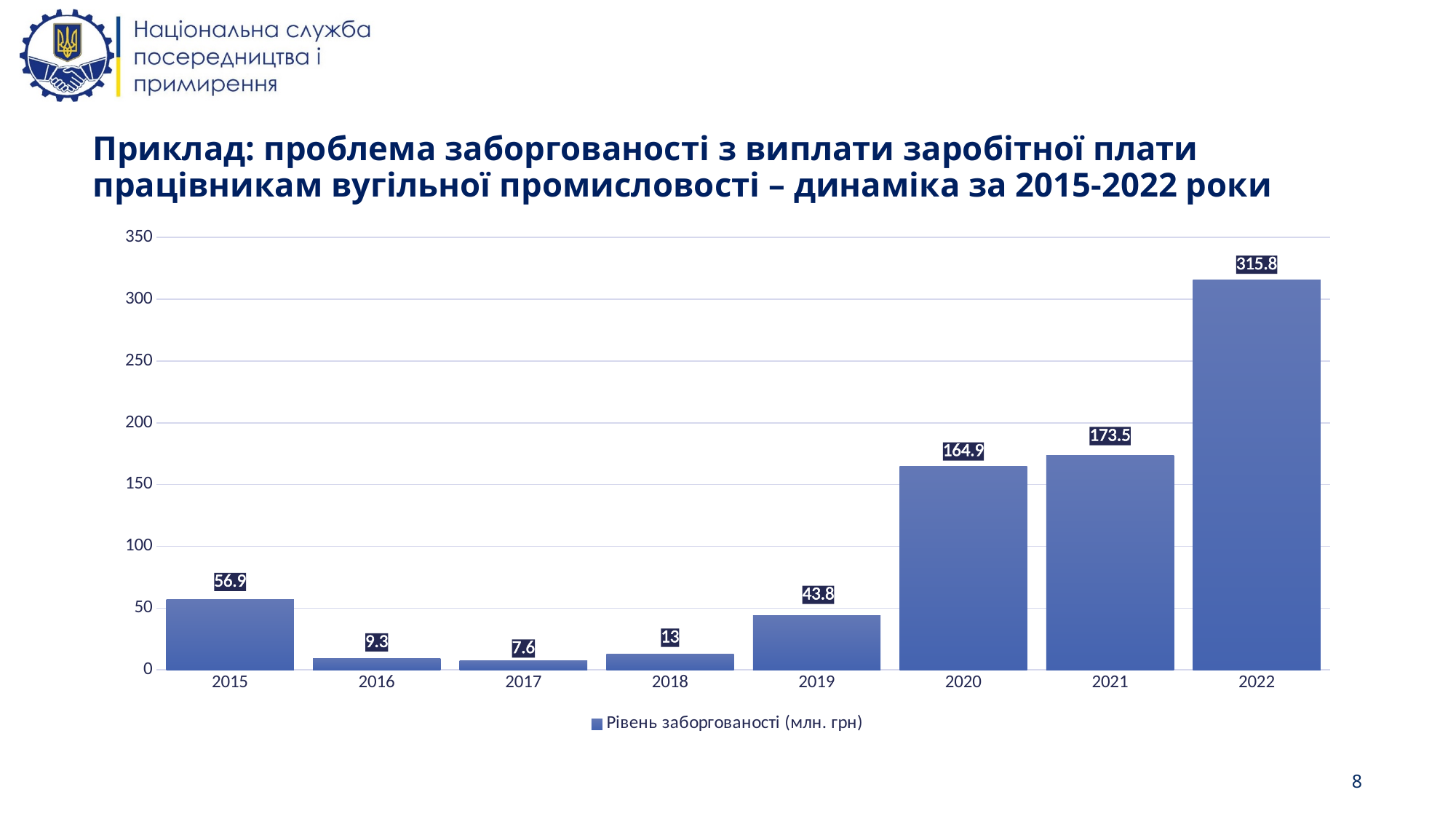
What is the value for 2020? 164.9 Is the value for 2021 greater or less than 150? greater What is the difference between the values for 2022 and 2021? 142.3 What kind of chart is shown on the slide? bar chart What is the value for 2018? 13 What is the legend entry for the series? Рівень заборгованості (млн. грн) How many years are shown on the x axis? 8 Which year has the highest value? 2022 Which is larger, the value for 2015 or the value for 2019? 2015 Which year has the lowest value? 2017 What is the value for 2015? 56.9 What is the difference between the values for 2016 and 2017? 1.7